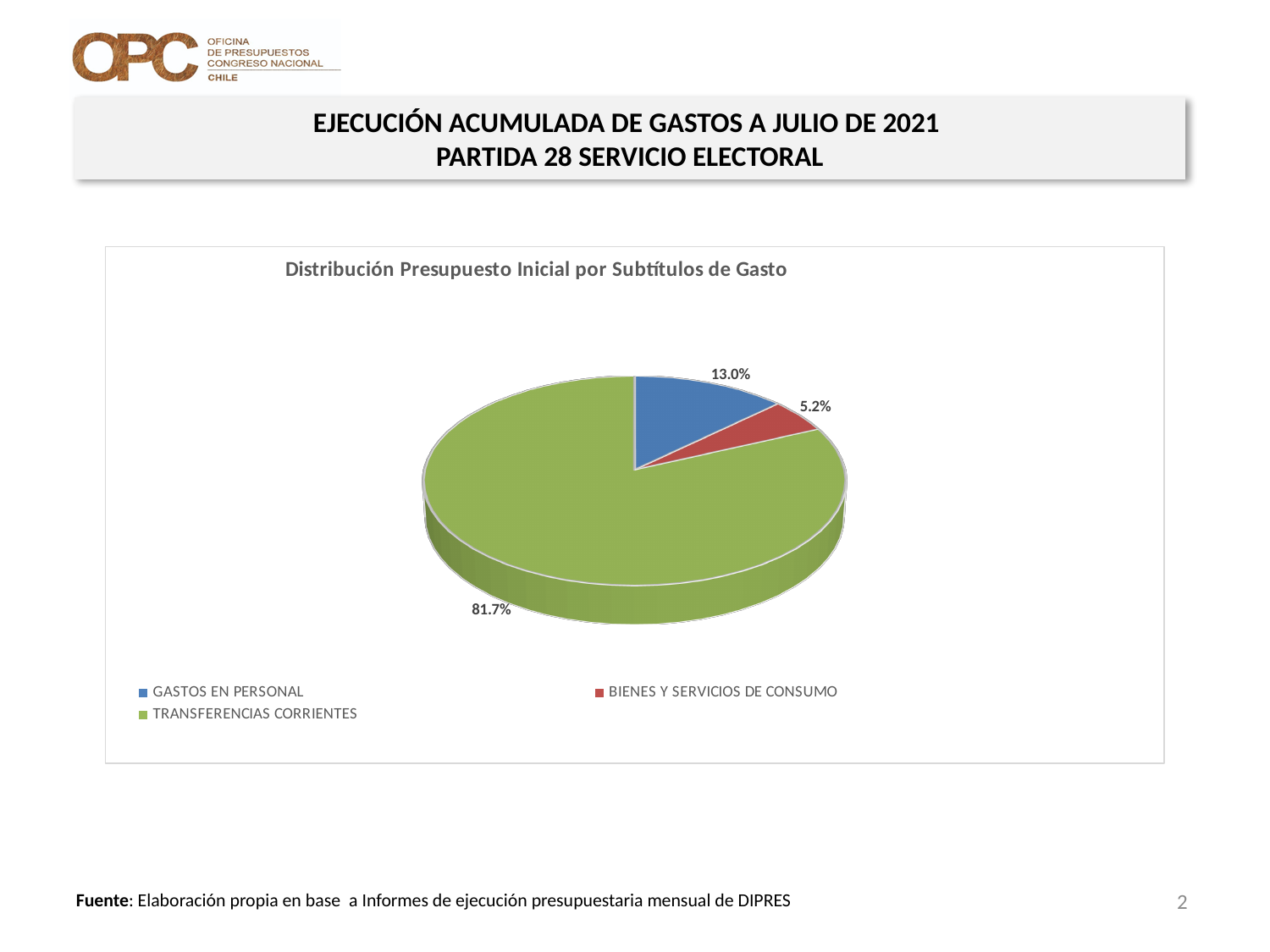
What is the title of the chart? Distribución Presupuesto Inicial por Subtítulos de Gasto What share of the pie does BIENES Y SERVICIOS DE CONSUMO represent? 5.2% Which is larger, the share for GASTOS EN PERSONAL or the share for BIENES Y SERVICIOS DE CONSUMO? GASTOS EN PERSONAL What share of the pie does TRANSFERENCIAS CORRIENTES represent? 81.7% What is the difference in percentage points between the TRANSFERENCIAS CORRIENTES share and the GASTOS EN PERSONAL share? 68.7 percentage points What colour is the slice for TRANSFERENCIAS CORRIENTES? Green Which category has the smallest slice of the pie? BIENES Y SERVICIOS DE CONSUMO What share of the pie does GASTOS EN PERSONAL represent? 13.0% How many entries does the legend list? 3 What kind of chart is shown on the slide? Pie chart Which category has the largest slice of the pie? TRANSFERENCIAS CORRIENTES How many categories does the pie chart show? 3